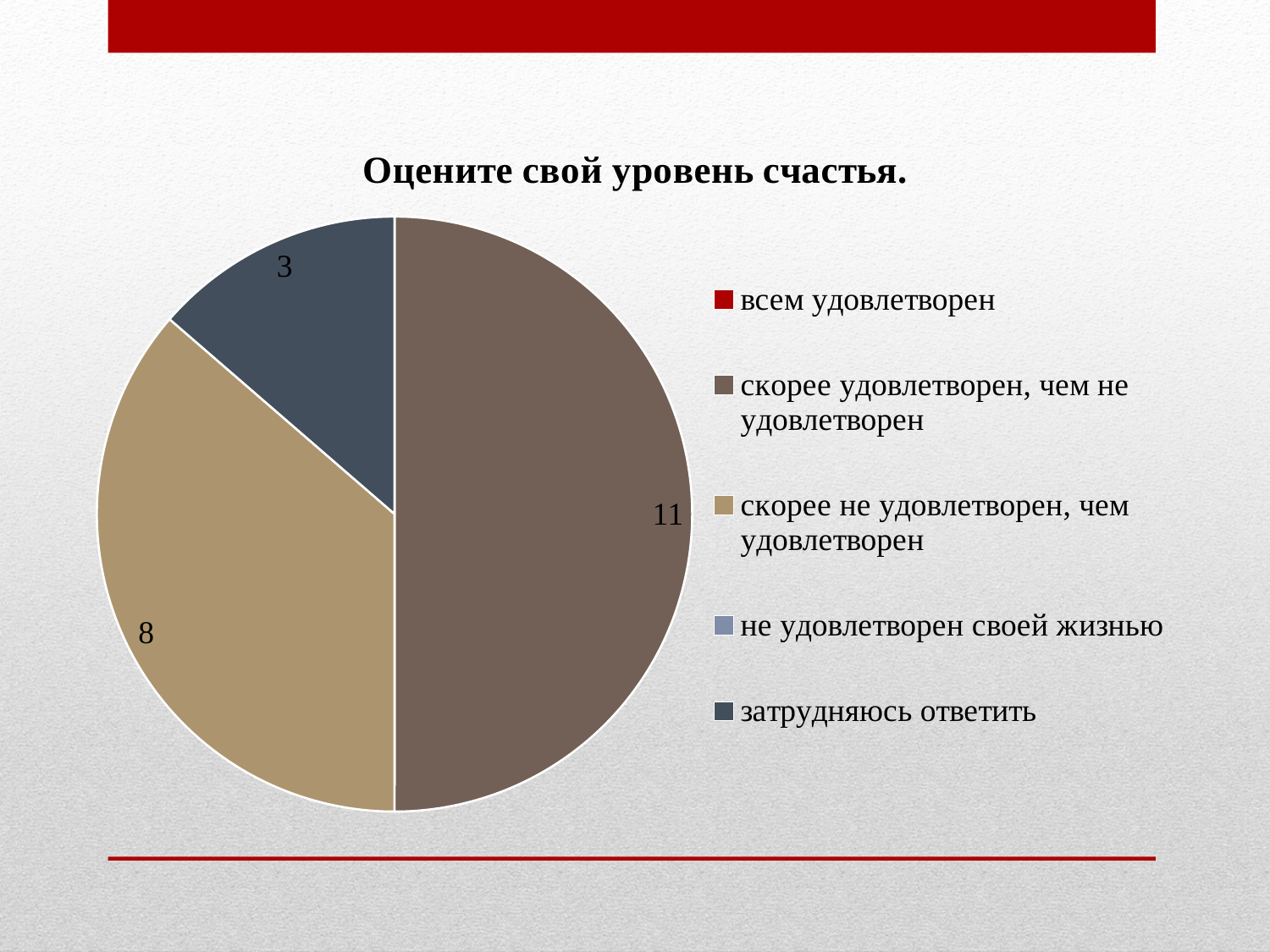
How many entries does the legend list? 5 Which category has the largest slice of the pie? скорее удовлетворен, чем не удовлетворен What is the total of the labelled slice values in the pie? 22 What is the value for "скорее удовлетворен, чем не удовлетворен"? 11 What kind of chart is shown on the slide? pie chart What share of the labelled total does the "скорее удовлетворен, чем не удовлетворен" slice represent? 50% Which is larger: the value for "скорее не удовлетворен, чем удовлетворен" or the value for "затрудняюсь ответить"? скорее не удовлетворен, чем удовлетворен What is the value for "затрудняюсь ответить"? 3 What is the value for "скорее не удовлетворен, чем удовлетворен"? 8 What is the title of the chart? Оцените свой уровень счастья. Which of the labelled slices is the smallest? затрудняюсь ответить What is the difference between the values for "скорее удовлетворен, чем не удовлетворен" and "скорее не удовлетворен, чем удовлетворен"? 3